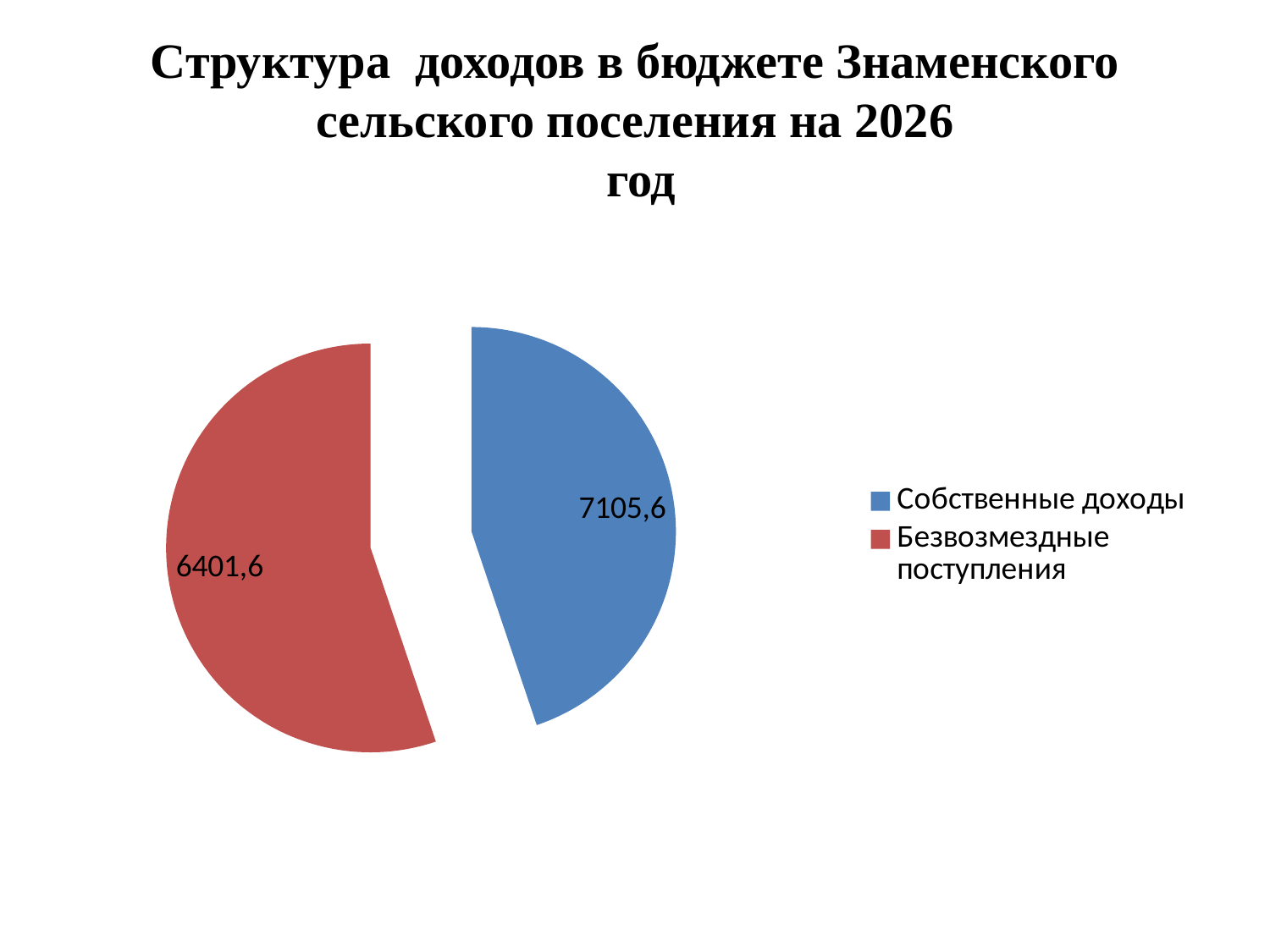
What kind of chart is shown on the slide? Pie chart What value is labelled on the red slice of the pie? 6401,6 What value is labelled on the blue slice of the pie? 7105,6 What value is shown for Безвозмездные поступления? 6401,6 What is the difference between the values for Собственные доходы and Безвозмездные поступления? 704 What year does the chart title refer to? 2026 Which legend entry is shown in blue? Собственные доходы How many slices does the pie chart have? 2 What value is shown for Собственные доходы? 7105,6 How many entries does the legend list? 2